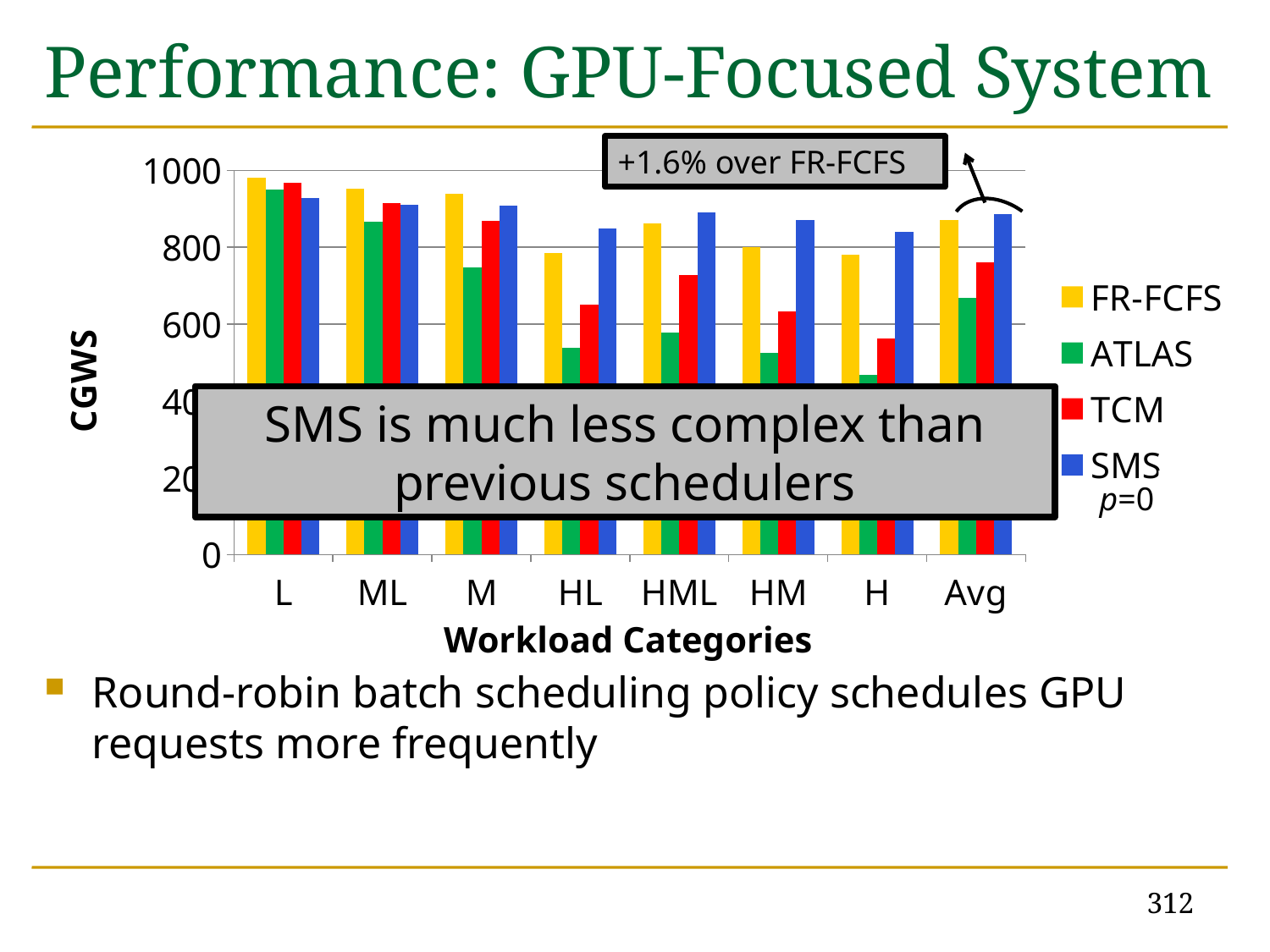
What is the label on the x axis? Workload Categories Which series has the lowest value for the H category? ATLAS Which is larger for the HML category, SMS or TCM? SMS Which series has the highest value for the HL category? SMS Is the FR-FCFS value for L greater or less than 800? greater Which series has the lowest value for the HL category? ATLAS How many series does the legend list? 4 What is the label on the y axis? CGWS Which is larger for the M category, FR-FCFS or ATLAS? FR-FCFS Is the ATLAS value for HM greater or less than 600? less How many workload categories are shown on the x axis? 8 What kind of chart is shown on the slide? bar chart